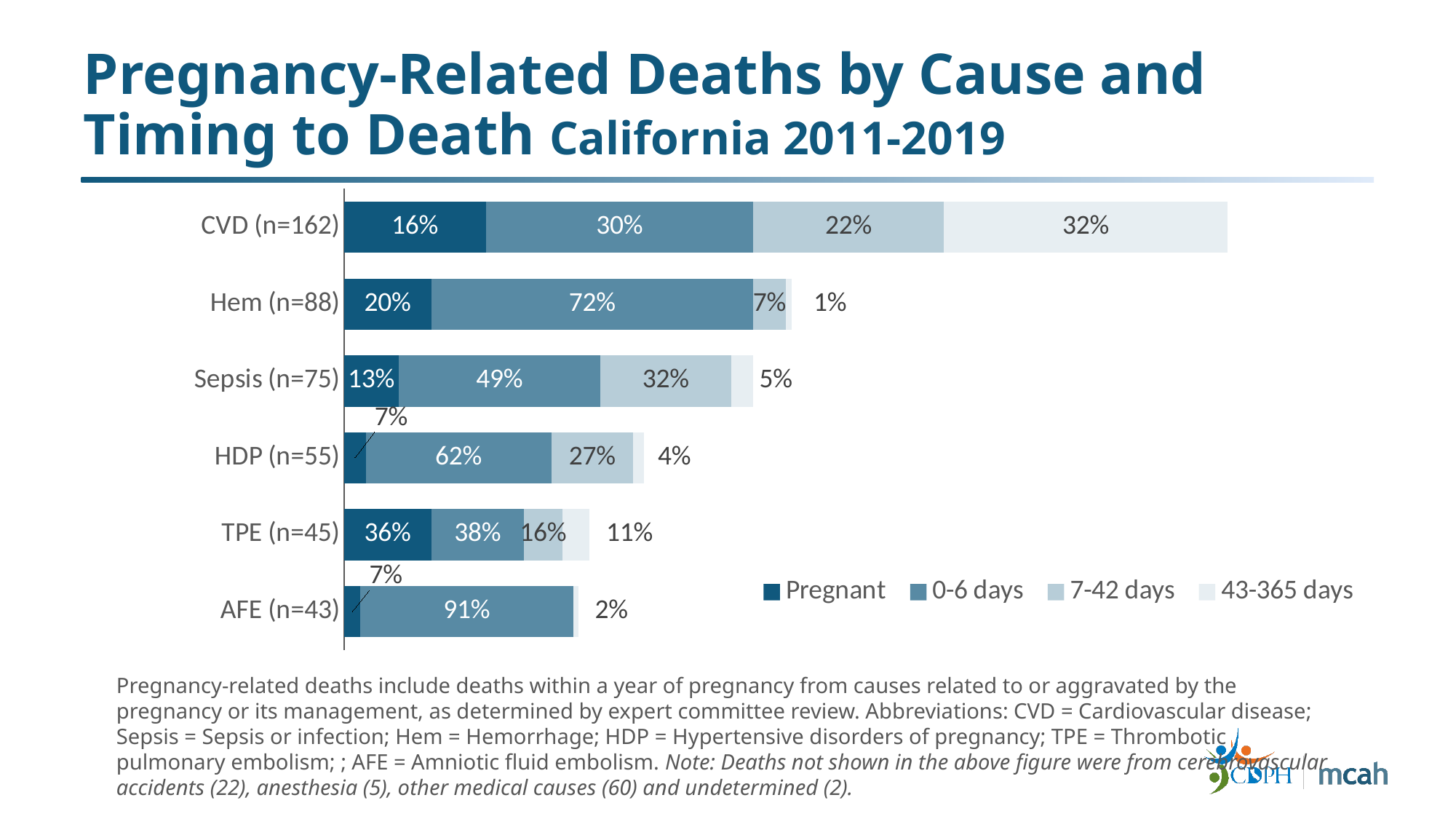
What percentage of TPE (n=45) deaths occurred while pregnant? 36% What percentage of Sepsis (n=75) deaths occurred 7-42 days after pregnancy? 32% What percentage of Hem (n=88) deaths occurred 0-6 days after pregnancy? 72% Which cause has the lowest share of deaths in the 43-365 days period? Hem (n=88) How many timing categories does the legend list? 4 Which has a larger 0-6 days share, Hem (n=88) or Sepsis (n=75)? Hem (n=88) What type of chart is shown on the slide? Stacked bar chart How many causes of death are shown in the chart? 6 Which cause has the highest share of deaths in the 0-6 days period? AFE (n=43) What percentage of CVD pregnancy-related deaths occurred 43-365 days after pregnancy? 32% For CVD, how many percentage points higher is the 43-365 days share than the Pregnant share? 16 percentage points Which cause has the highest share of deaths occurring while pregnant? TPE (n=45)